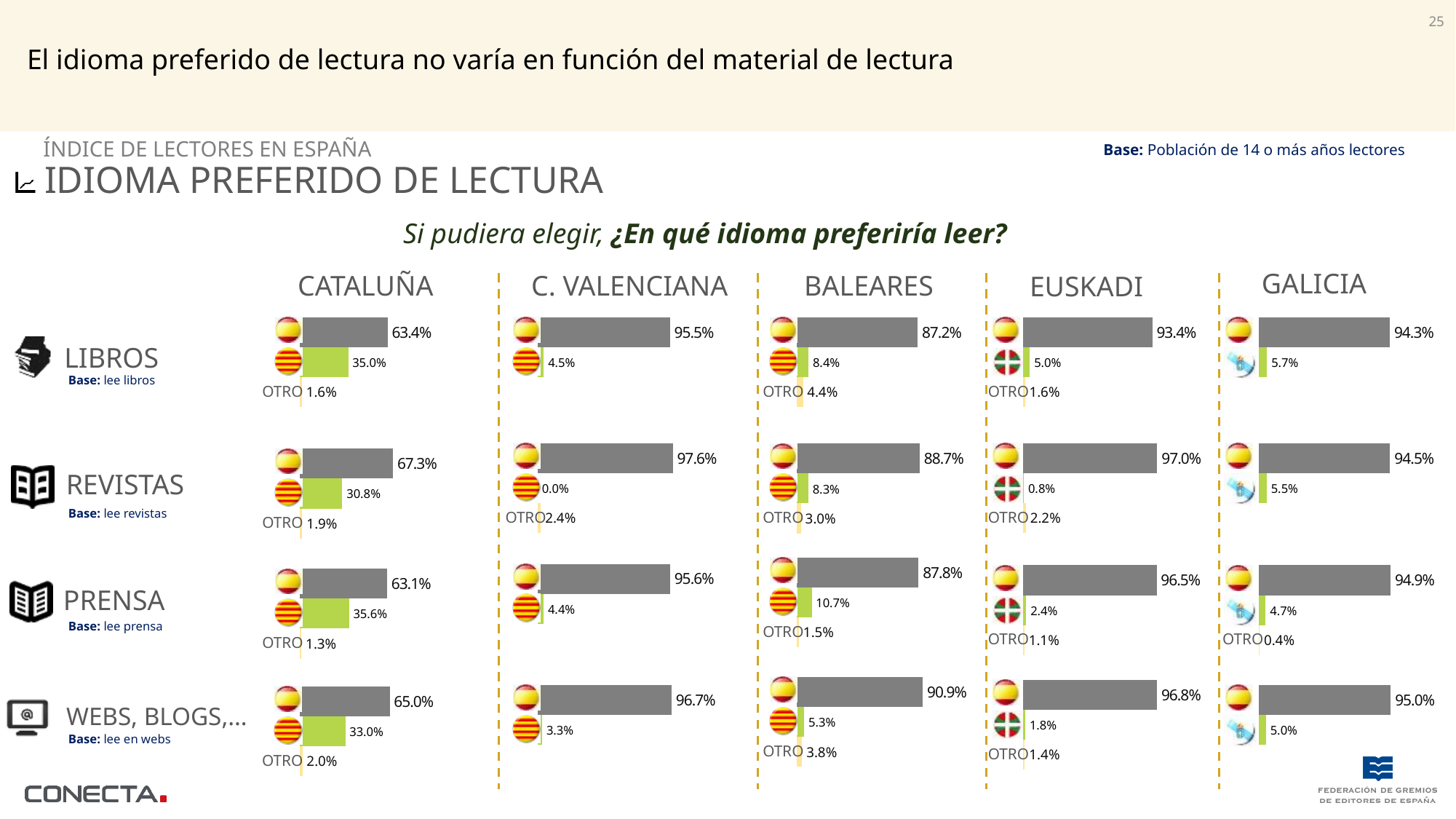
How many bars are shown in the Cataluña WEBS, BLOGS,... chart? 3 In the C. Valenciana REVISTAS chart, what value is shown for the second bar (regional flag)? 0.0% In the Cataluña LIBROS chart, what value is shown for the top bar (Spanish flag)? 63.4% In the Cataluña LIBROS chart, what value is shown for the second bar (Catalan flag)? 35.0% What type of chart is used for the Cataluña LIBROS data? Bar chart Which is larger: the OTRO value in the Baleares LIBROS chart or the OTRO value in the Euskadi LIBROS chart? Baleares LIBROS In the Galicia WEBS, BLOGS,... chart, what is the difference between the top bar (95.0%) and the second bar (5.0%)? 90.0% In the Cataluña REVISTAS chart, what is the difference between the top bar (67.3%) and the second bar (30.8%)? 36.5% In the Galicia PRENSA chart, what value is shown for OTRO? 0.4% In the Baleares PRENSA chart, what value is shown for the second bar (regional flag)? 10.7% Across the Euskadi column, which reading material has the lowest value for the second bar (Basque flag)? REVISTAS Across the LIBROS row, which region has the highest value for the top bar (Spanish flag)? C. Valenciana